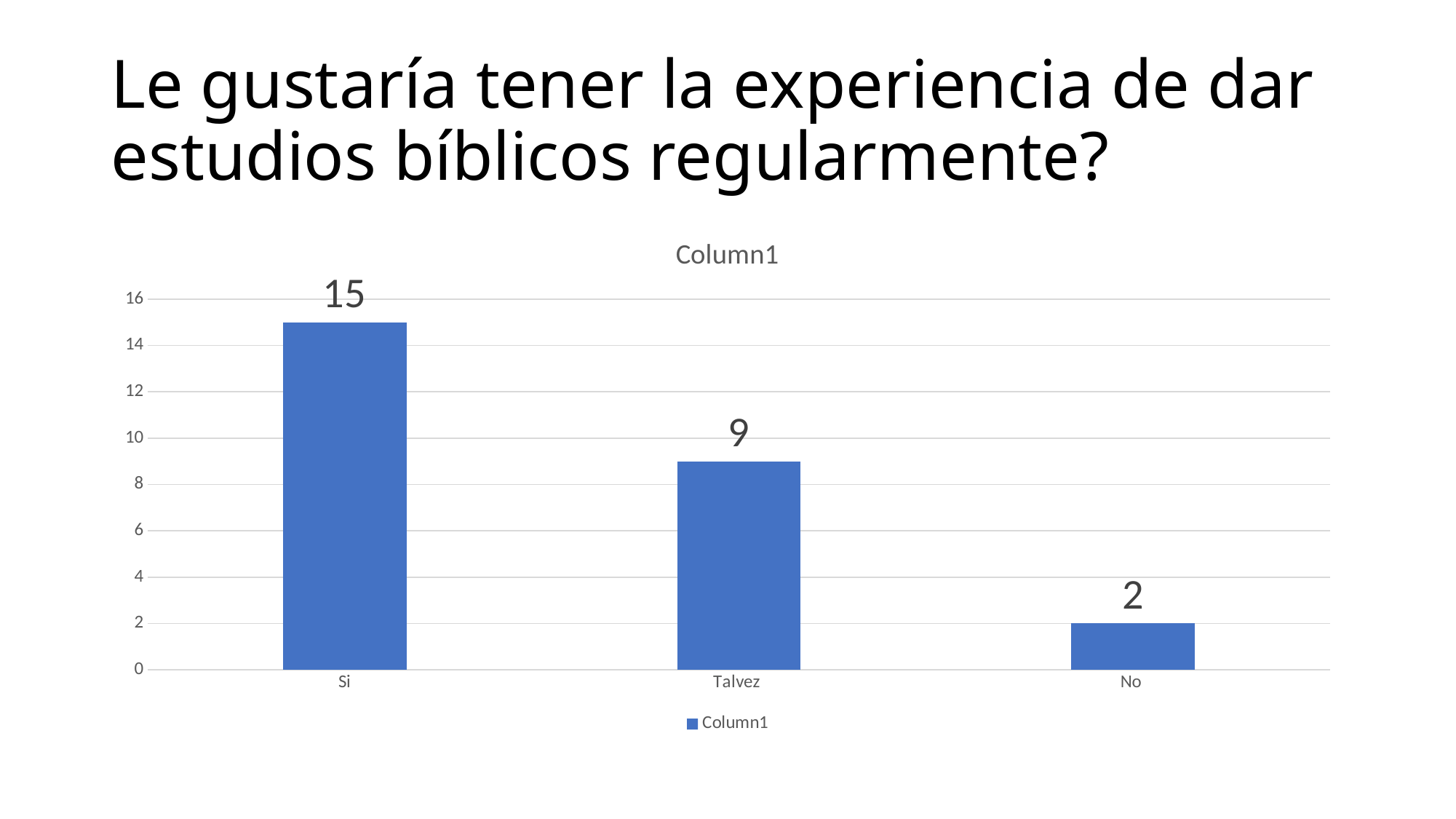
Which is larger, the value for Talvez or the value for No? Talvez What is the value for No? 2 What kind of chart is shown on the slide? bar chart What is the title of the chart? Column1 What is the difference between the values for Talvez and No? 7 What is the value for Talvez? 9 Is the value for Talvez greater or less than 10? less What is the difference between the values for Si and Talvez? 6 How many categories are shown on the x axis? 3 Which category has the highest value? Si Which category has the lowest value? No What is the value for Si? 15